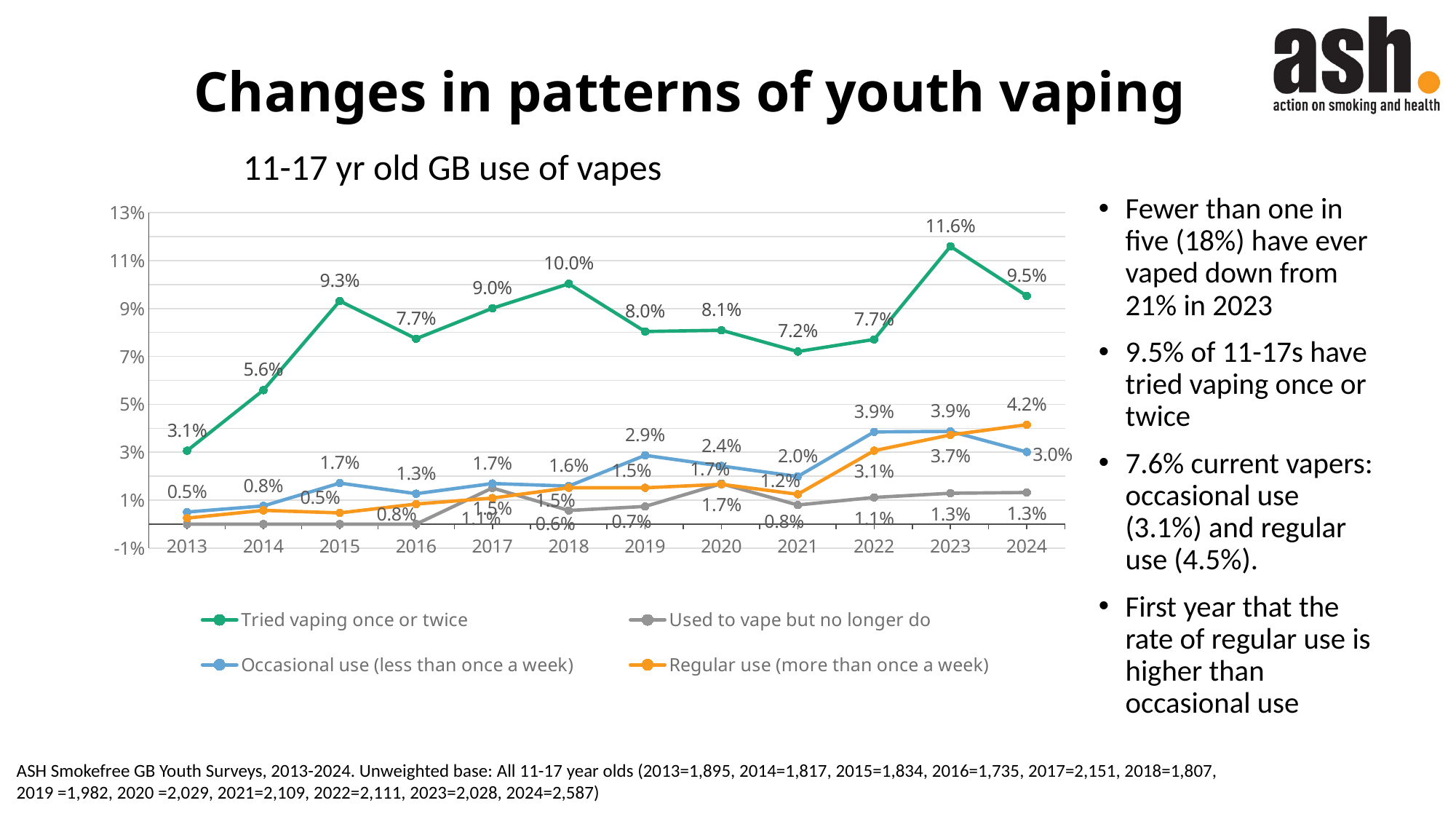
What is the title of the chart? 11-17 yr old GB use of vapes How many years are plotted along the x axis of the chart? 12 What is the value for 'Tried vaping once or twice' in 2013? 3.1% What is the value for 'Tried vaping once or twice' in 2023? 11.6% In which year is 'Tried vaping once or twice' at its highest? 2023 What is the difference between the 'Tried vaping once or twice' values for 2023 and 2024? 2.1% How many series does the chart legend list? 4 What is the value for 'Regular use (more than once a week)' in 2024? 4.2% In 2024, which is larger: 'Regular use (more than once a week)' or 'Occasional use (less than once a week)'? Regular use (more than once a week) In which year is 'Tried vaping once or twice' at its lowest? 2013 What type of chart is shown on the slide? Line chart What is the value for 'Occasional use (less than once a week)' in 2024? 3.0%